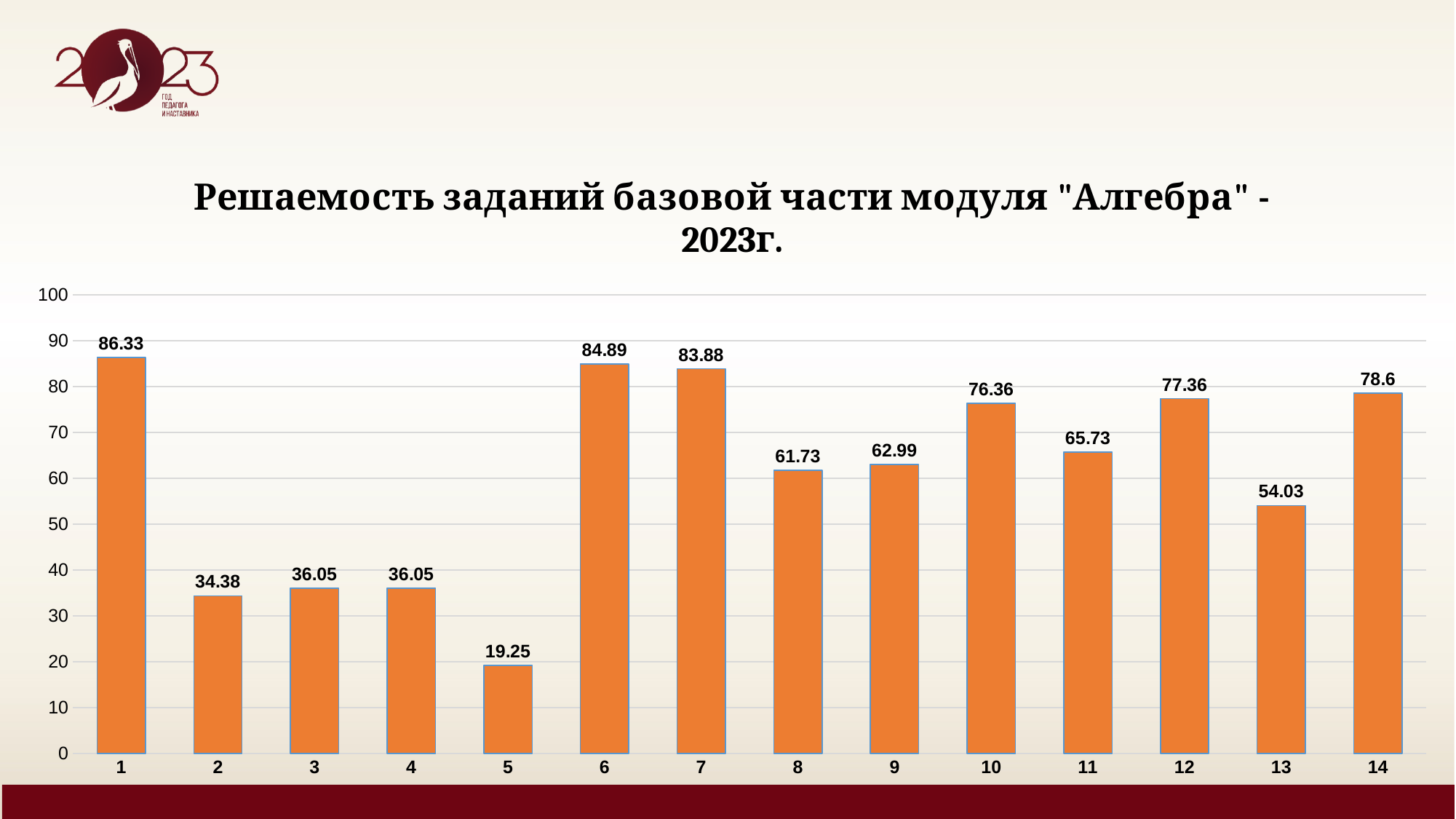
What is the value for task 5? 19.25 What is the difference between the values for task 12 and task 13? 23.33 What is the difference between the values for task 6 and task 7? 1.01 What is the value for task 14? 78.6 Is the value for task 11 greater or less than 60? greater How many tasks are shown on the x axis? 14 What is the title of the chart? Решаемость заданий базовой части модуля "Алгебра" - 2023г. What kind of chart is shown on the slide? bar chart Which task has the lowest value? 5 Which task has the highest value? 1 Which is larger, the value for task 8 or the value for task 9? 9 What is the value for task 1? 86.33